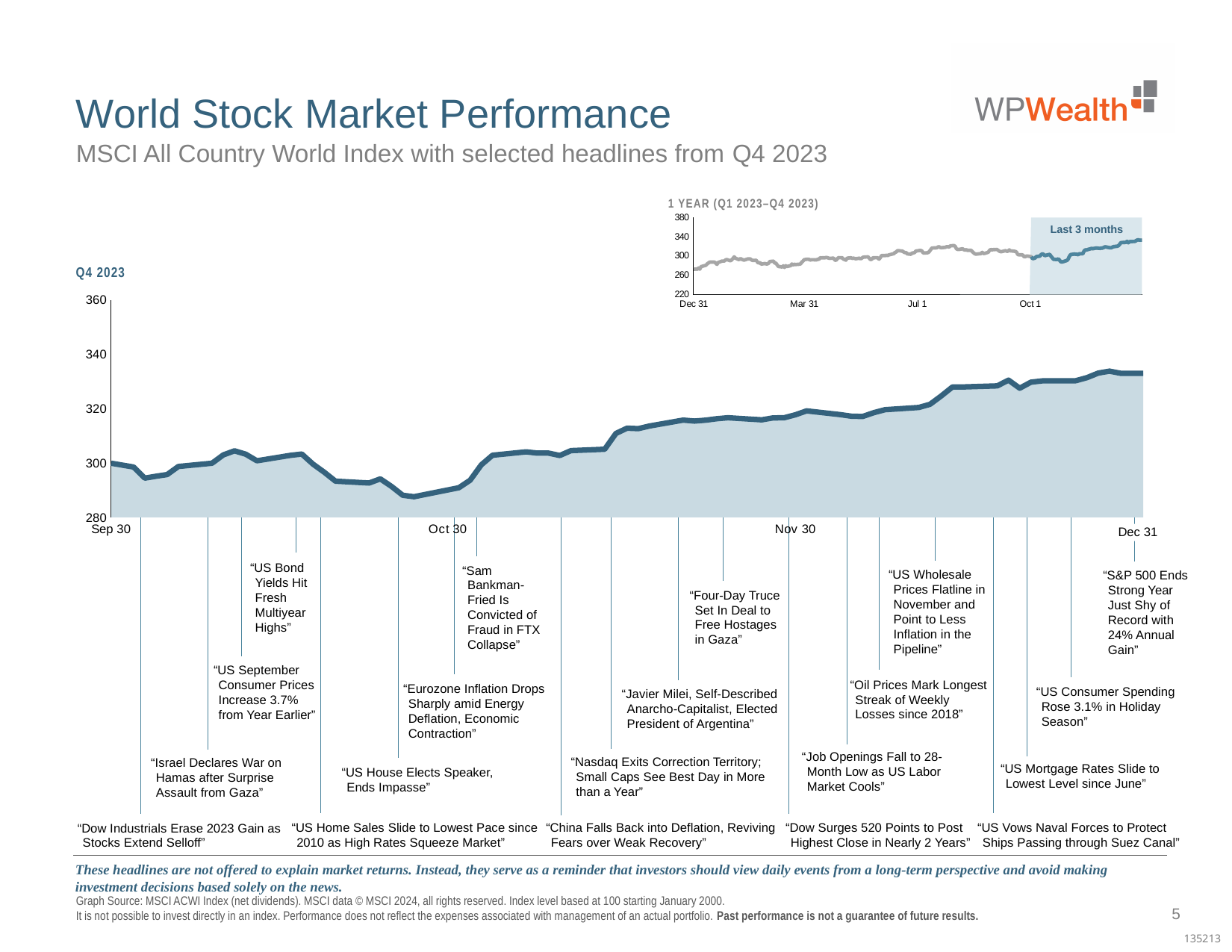
On the main Q4 2023 chart, which is larger, the value at Sep 30 or the value at Dec 31? Dec 31 What is the highest value shown on the y axis of the main Q4 2023 chart? 360 On the inset 1 YEAR chart, is the value at Oct 1 greater or less than 340? less On the main Q4 2023 chart, does the index level overall rise or fall from Sep 30 to Dec 31? rise On the inset 1 YEAR chart, which is larger, the value at Dec 31 (start) or the value at the end of the line? the end of the line How many date labels are shown on the x axis of the main Q4 2023 chart? 4 On the main Q4 2023 chart, is the value at Nov 30 greater or less than 300? greater What is the title of the small inset chart at the top right? 1 YEAR (Q1 2023–Q4 2023) On the inset 1 YEAR chart, what is the lowest value shown on the y axis? 220 What kind of chart is the main Q4 2023 chart on the slide? Line chart (area chart) On the main Q4 2023 chart, is the lowest point of the line greater or less than 300? less